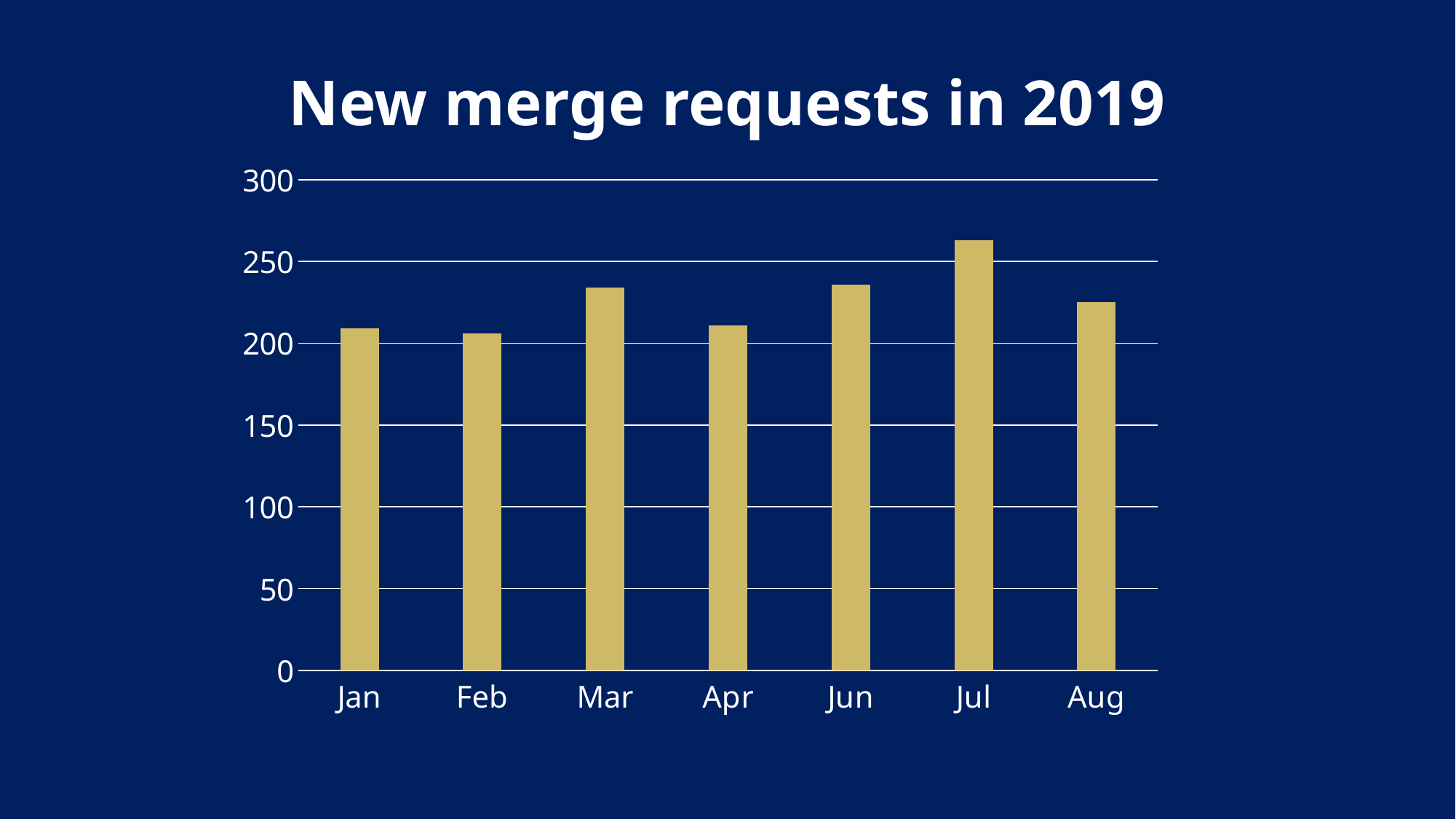
What is the highest value shown on the y axis of the chart? 300 What is the title of the chart? New merge requests in 2019 How many months are shown on the x axis of the chart? 7 Which is larger, the value for Apr or the value for Jun? Jun Is the value for Jul greater or less than 250? greater Which month has the highest number of new merge requests? Jul Which is larger, the value for Jul or the value for Aug? Jul Is the value for Aug greater or less than 250? less Is the value for Feb greater or less than 250? less Which is larger, the value for Mar or the value for Jan? Mar What kind of chart is shown on the slide? bar chart